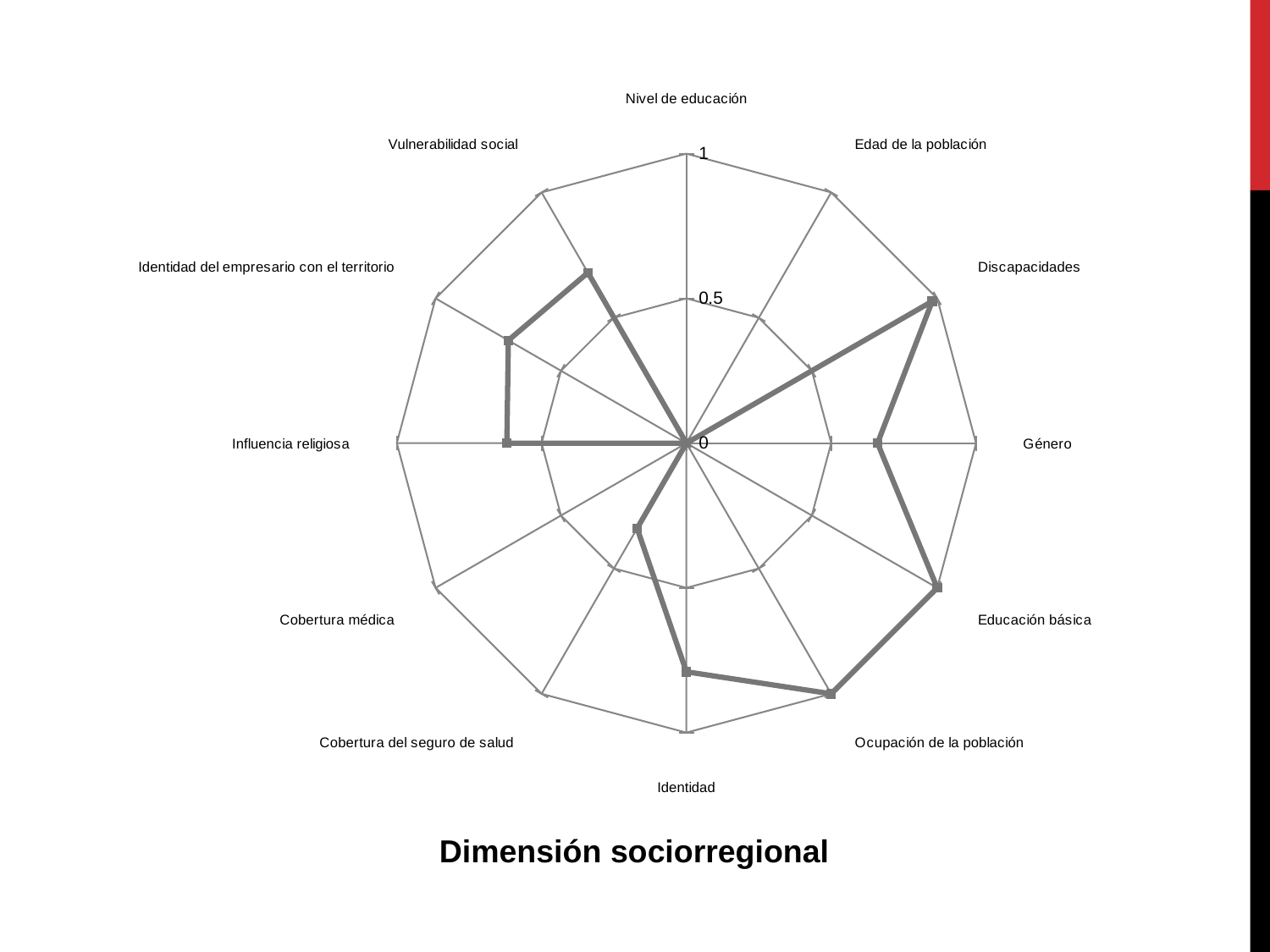
What is the value for Educación básica? 1 Which has the larger value, Identidad or Cobertura del seguro de salud? Identidad What is the title of the chart? Dimensión sociorregional Is the value for Identidad greater or less than 0.5? greater What is the value for Ocupación de la población? 1 How many categories (axes) does the radar chart have? 12 What is the value for Nivel de educación? 0 What is the value for Cobertura médica? 0 Is the value for Cobertura del seguro de salud greater or less than 0.5? less What type of chart is shown on the slide? Radar chart Is the value for Género greater or less than 0.5? greater